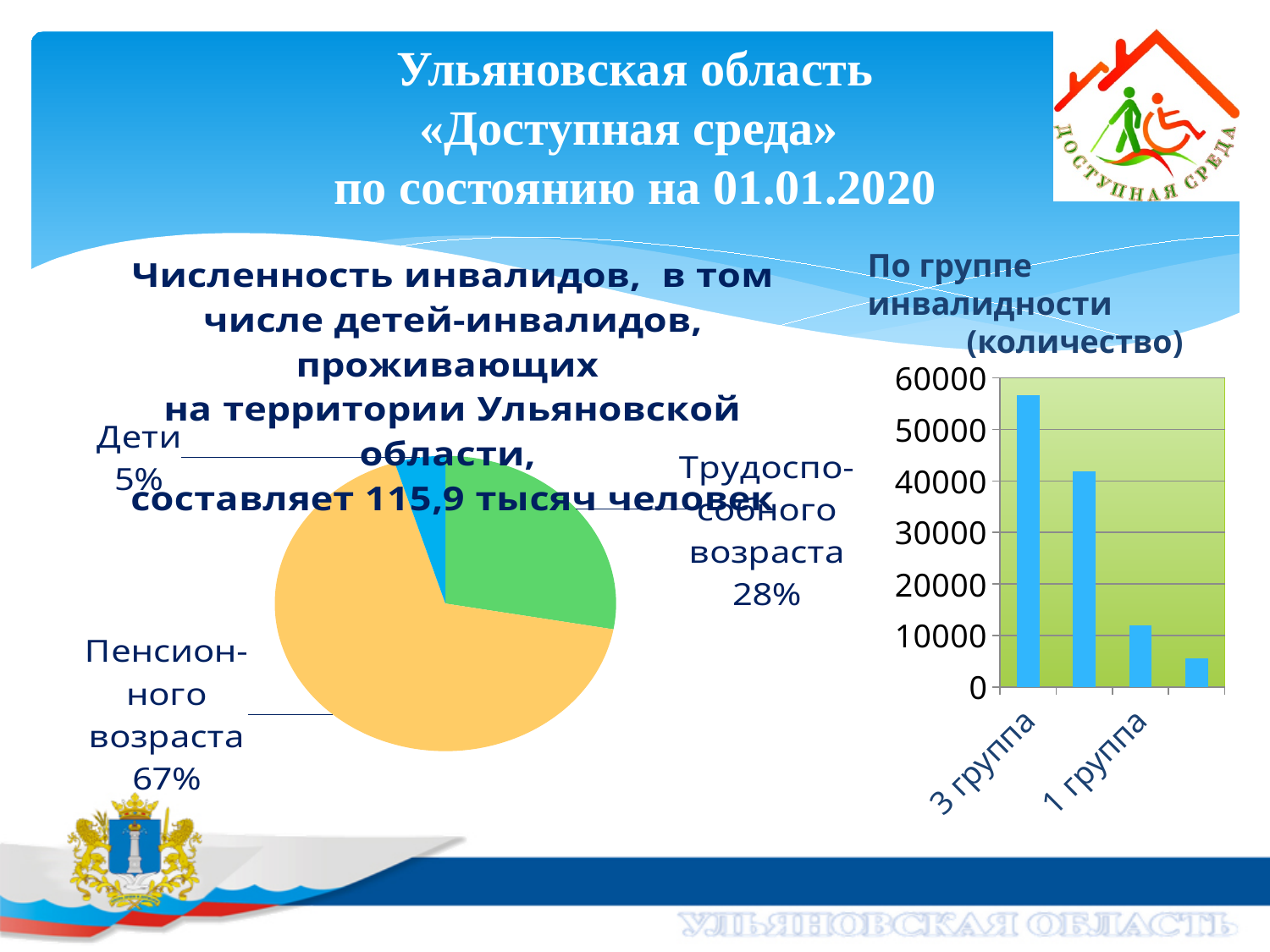
What kind of chart is the chart titled «По группе инвалидности (количество)»? bar chart In the pie chart on the left, how many percentage points larger is the share of «Пенсионного возраста» than «Трудоспособного возраста»? 39 In the chart «По группе инвалидности (количество)», is the value for «3 группа» greater or less than 50000? greater In the pie chart on the left, what share is labelled for «Трудоспособного возраста»? 28% In the pie chart on the left, what share is labelled for «Пенсионного возраста»? 67% In the pie chart on the left, what share is labelled for «Дети»? 5% What kind of chart is the chart on the left of the slide? pie chart How many bars does the chart «По группе инвалидности (количество)» have? 4 In the chart «По группе инвалидности (количество)», which is larger, the value for «3 группа» or for «1 группа»? 3 группа In the pie chart on the left, which category has the smallest share? Дети In the pie chart on the left, which category has the largest share? Пенсионного возраста How many slices does the pie chart on the left have? 3